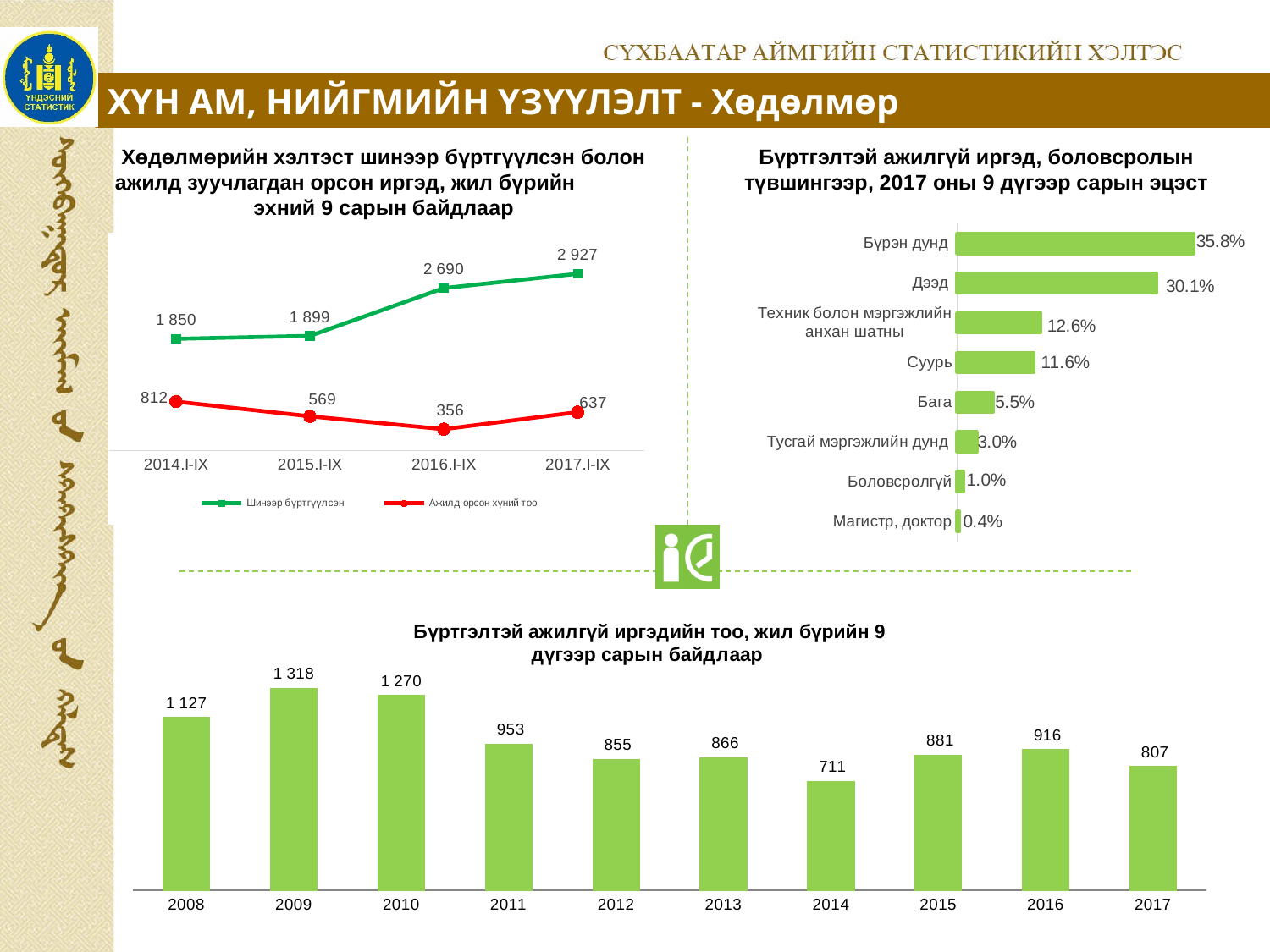
In the top-left line chart, what is the value of the 'Ажилд орсон хүний тоо' series for 2016.I-IX? 356 In the top-right chart 'Бүртгэлтэй ажилгүй иргэд, боловсролын түвшингээр', which category has the highest value? Бүрэн дунд In the top-left line chart, how many series does the legend list? 2 In the top-right chart 'Бүртгэлтэй ажилгүй иргэд, боловсролын түвшингээр', how many categories are shown? 8 In the top-left line chart, what is the value of the 'Шинээр бүртгүүлсэн' series for 2017.I-IX? 2 927 In the top-right chart 'Бүртгэлтэй ажилгүй иргэд, боловсролын түвшингээр', what is the value for 'Дээд'? 30.1% In the bottom chart 'Бүртгэлтэй ажилгүй иргэдийн тоо', which year has the highest value? 2009 In the bottom chart 'Бүртгэлтэй ажилгүй иргэдийн тоо', what is the value for 2014? 711 In the top-left line chart, what is the difference between the 'Шинээр бүртгүүлсэн' values for 2016.I-IX and 2015.I-IX? 791 In the top-left line chart, does the 'Шинээр бүртгүүлсэн' series rise or fall from 2014.I-IX to 2017.I-IX? rise In the top-right chart 'Бүртгэлтэй ажилгүй иргэд, боловсролын түвшингээр', which category has the lowest value? Магистр, доктор In the bottom chart 'Бүртгэлтэй ажилгүй иргэдийн тоо', which is larger, the value for 2015 or the value for 2017? 2015